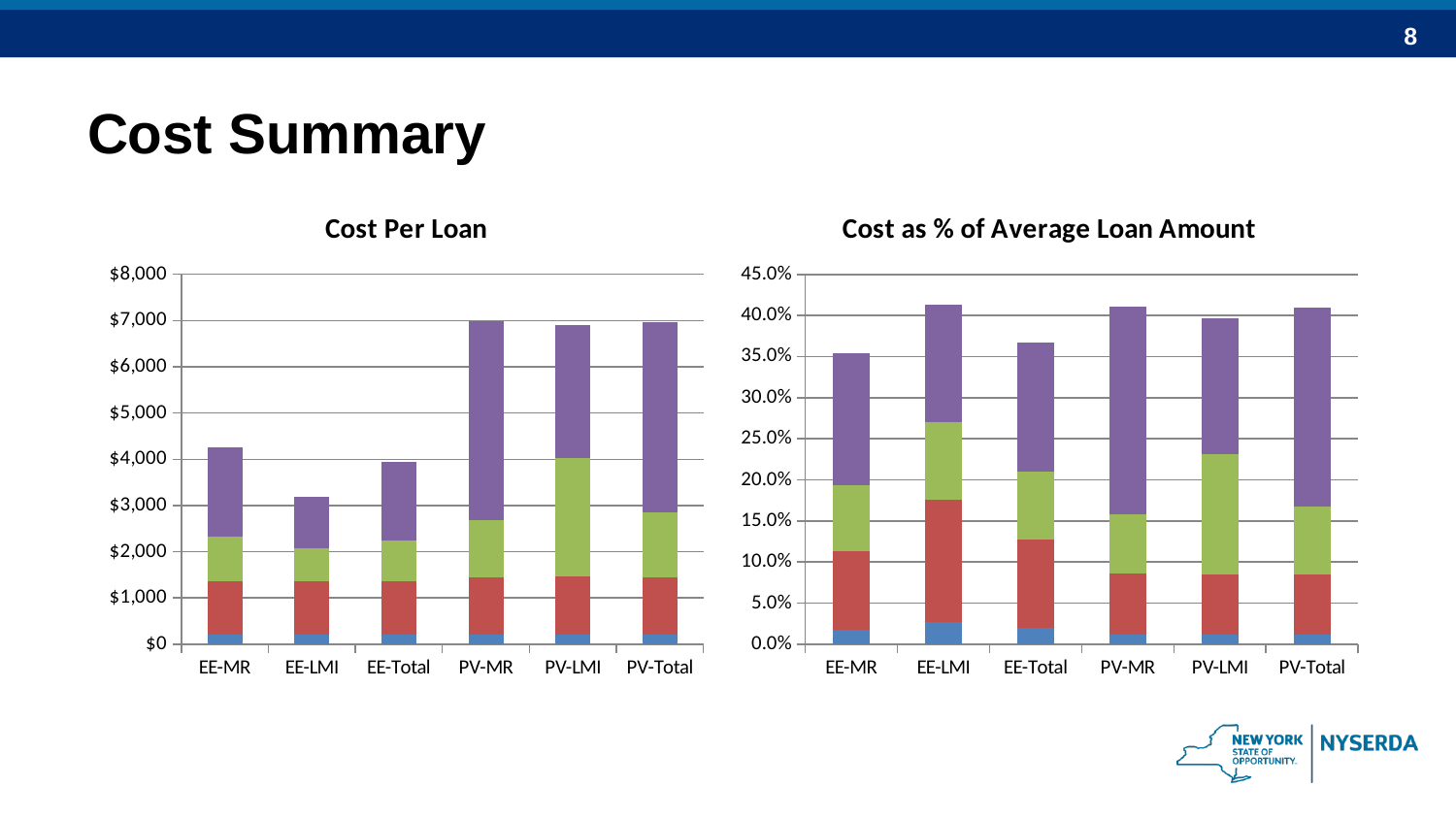
In the "Cost Per Loan" chart, is the total for EE-MR greater or less than $3,000? greater In the "Cost as % of Average Loan Amount" chart, is the total for EE-LMI greater or less than 40.0%? greater In the "Cost Per Loan" chart, is the total for EE-LMI greater or less than $4,000? less In the "Cost Per Loan" chart, which category has the lowest total bar? EE-LMI In the "Cost Per Loan" chart, which has the larger total bar, PV-MR or EE-MR? PV-MR How many categories are shown on the x axis of the "Cost Per Loan" chart? 6 What kind of chart is the "Cost Per Loan" chart? stacked bar chart What is the title of the chart on the right side of the slide? Cost as % of Average Loan Amount How many categories are shown on the x axis of the "Cost as % of Average Loan Amount" chart? 6 In the "Cost as % of Average Loan Amount" chart, which category has the lowest total bar? EE-MR